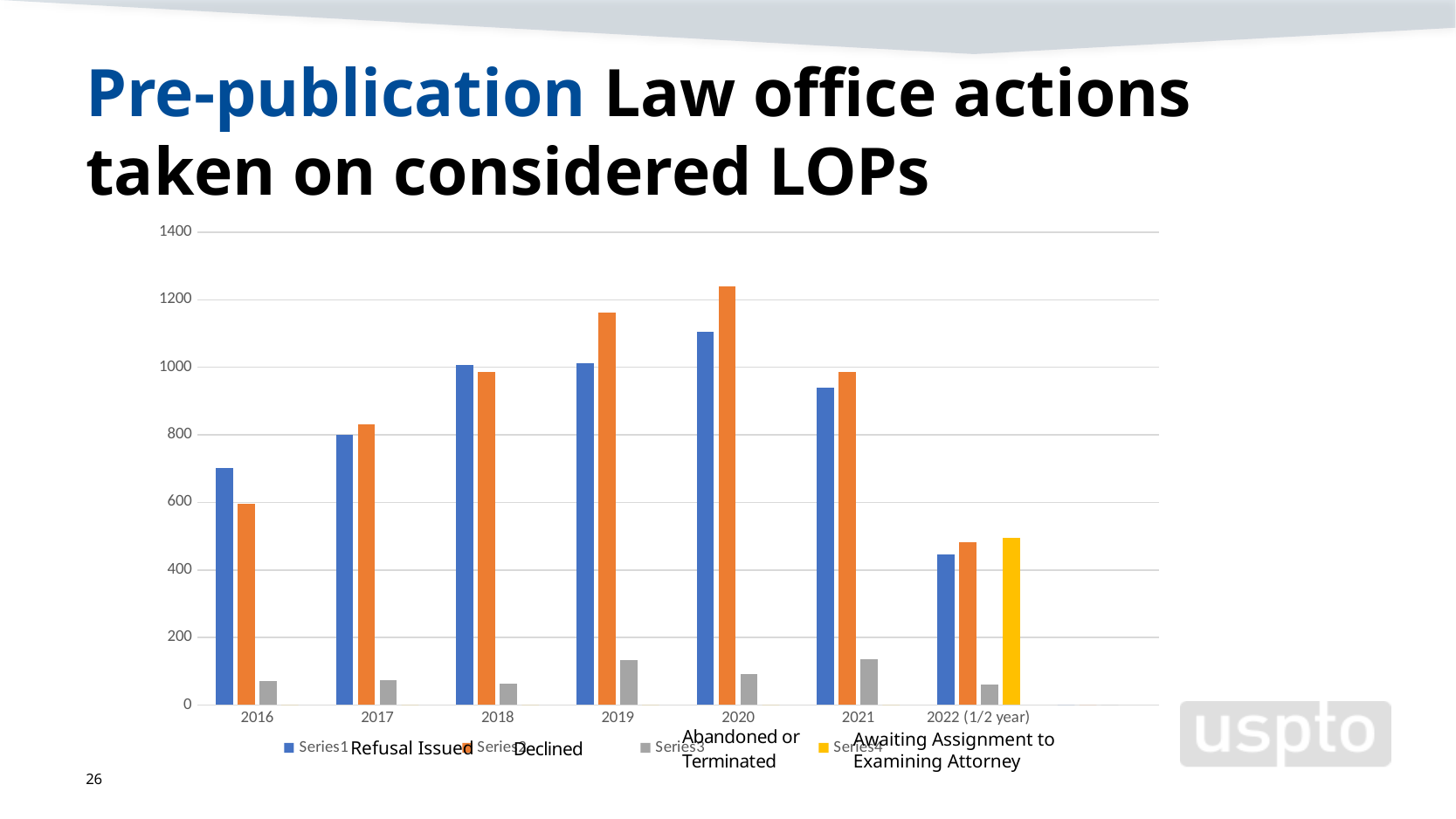
In which year is the Declined series highest? 2020 Is the value for Awaiting Assignment to Examining Attorney in 2022 (1/2 year) greater or less than 600? less How many year categories are shown on the x axis? 7 Is the value for Refusal Issued in 2021 greater or less than 1000? less What kind of chart is shown on the slide? bar chart Which year is the only one with a bar for Awaiting Assignment to Examining Attorney? 2022 (1/2 year) In which year is the Refusal Issued series lowest? 2022 (1/2 year) How many series does the legend list? 4 In which year is the Refusal Issued series highest? 2020 In 2019, which is larger: Refusal Issued or Declined? Declined Is the value for Refusal Issued in 2016 greater or less than 600? greater